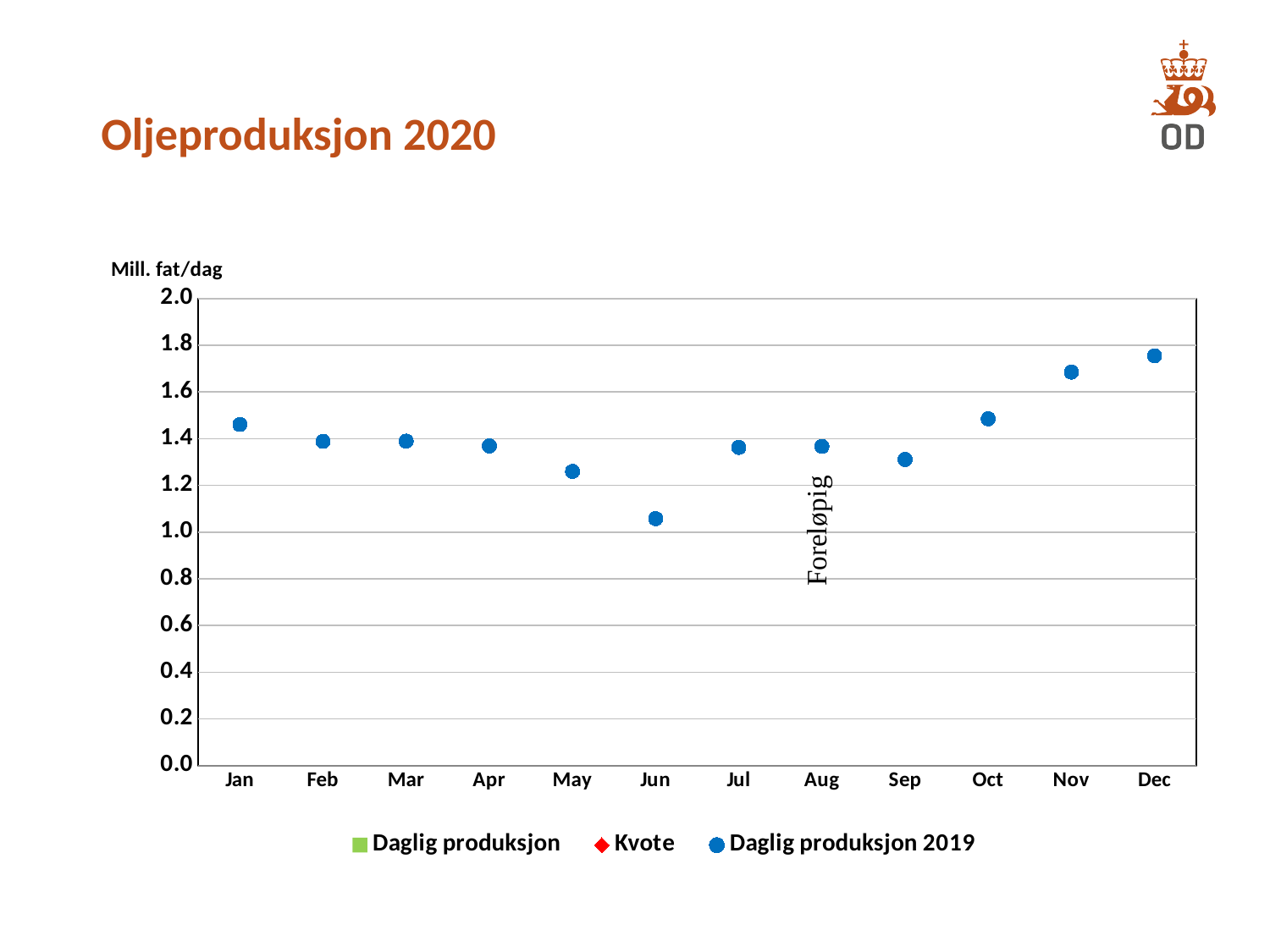
Which is larger for Daglig produksjon 2019, the value in Jan or the value in Dec? Dec How many series does the legend list? 3 What is the title of the chart on the slide? Oljeproduksjon 2020 What kind of chart is shown on the slide? scatter chart Is the value for Daglig produksjon 2019 in Jun greater or less than 1.2? less How many months are shown on the x axis? 12 Do the values for Daglig produksjon 2019 rise or fall from Sep to Dec? rise Is the value for Daglig produksjon 2019 in May greater or less than 1.4? less What unit is shown on the y axis of the chart? Mill. fat/dag Which month has the lowest value for Daglig produksjon 2019? Jun Is the value for Daglig produksjon 2019 in Dec greater or less than 1.6? greater Which month has the highest value for Daglig produksjon 2019? Dec